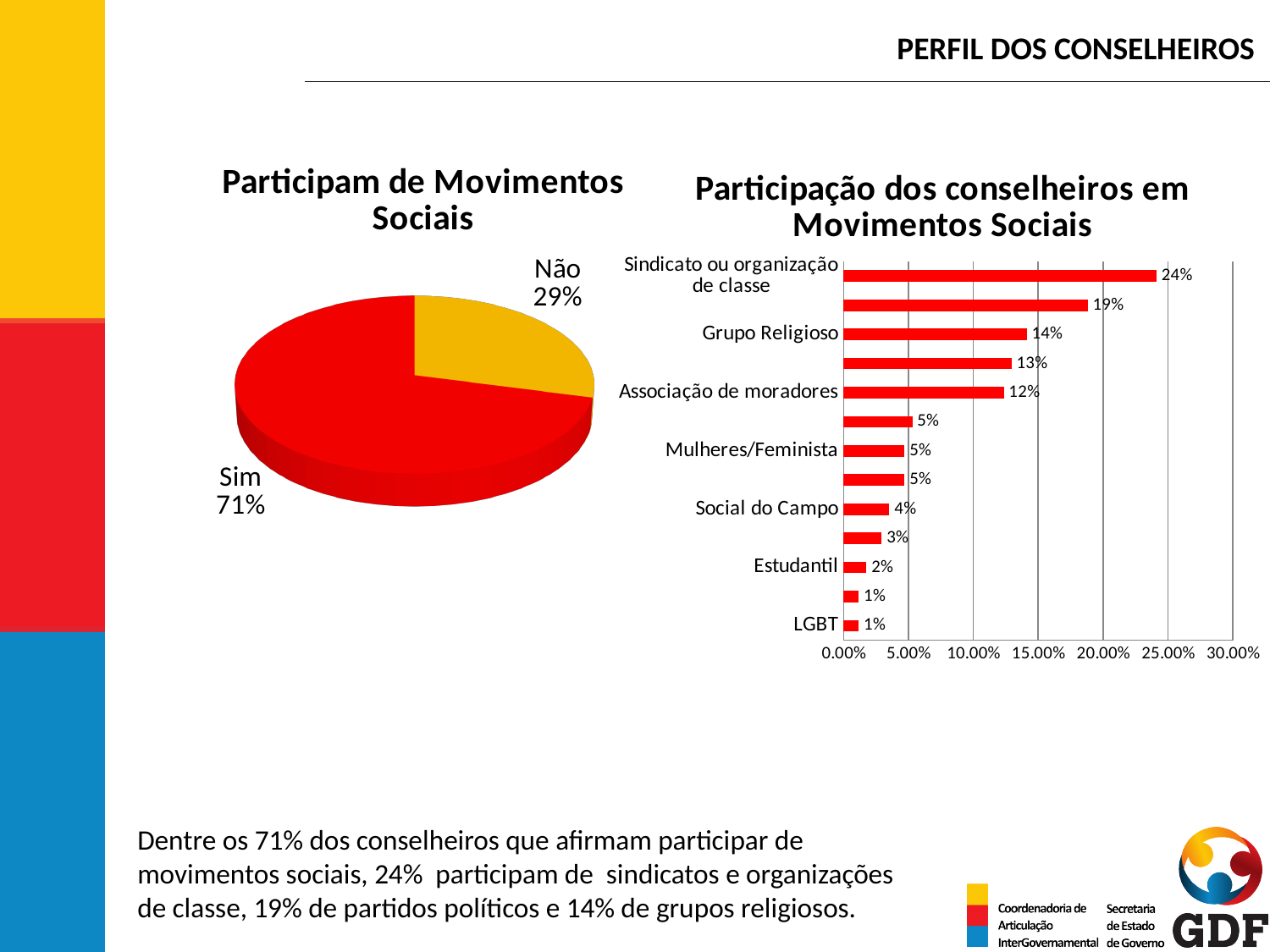
In the bar chart 'Participação dos conselheiros em Movimentos Sociais', how many bars are plotted? 13 In the bar chart 'Participação dos conselheiros em Movimentos Sociais', what is the value for 'Associação de moradores'? 12% In the pie chart 'Participam de Movimentos Sociais', which slice is larger, 'Sim' or 'Não'? Sim In the bar chart 'Participação dos conselheiros em Movimentos Sociais', what is the value for 'Grupo Religioso'? 14% In the bar chart 'Participação dos conselheiros em Movimentos Sociais', what is the value for 'Sindicato ou organização de classe'? 24% In the pie chart 'Participam de Movimentos Sociais', what share of the pie is 'Sim'? 71% In the bar chart 'Participação dos conselheiros em Movimentos Sociais', what is the difference between 'Sindicato ou organização de classe' and 'Grupo Religioso'? 10% What kind of chart is 'Participam de Movimentos Sociais'? Pie chart In the bar chart 'Participação dos conselheiros em Movimentos Sociais', which category has the highest value? Sindicato ou organização de classe In the pie chart 'Participam de Movimentos Sociais', what share of the pie is 'Não'? 29% What kind of chart is 'Participação dos conselheiros em Movimentos Sociais'? Bar chart In the bar chart 'Participação dos conselheiros em Movimentos Sociais', what is the value for 'Social do Campo'? 4%